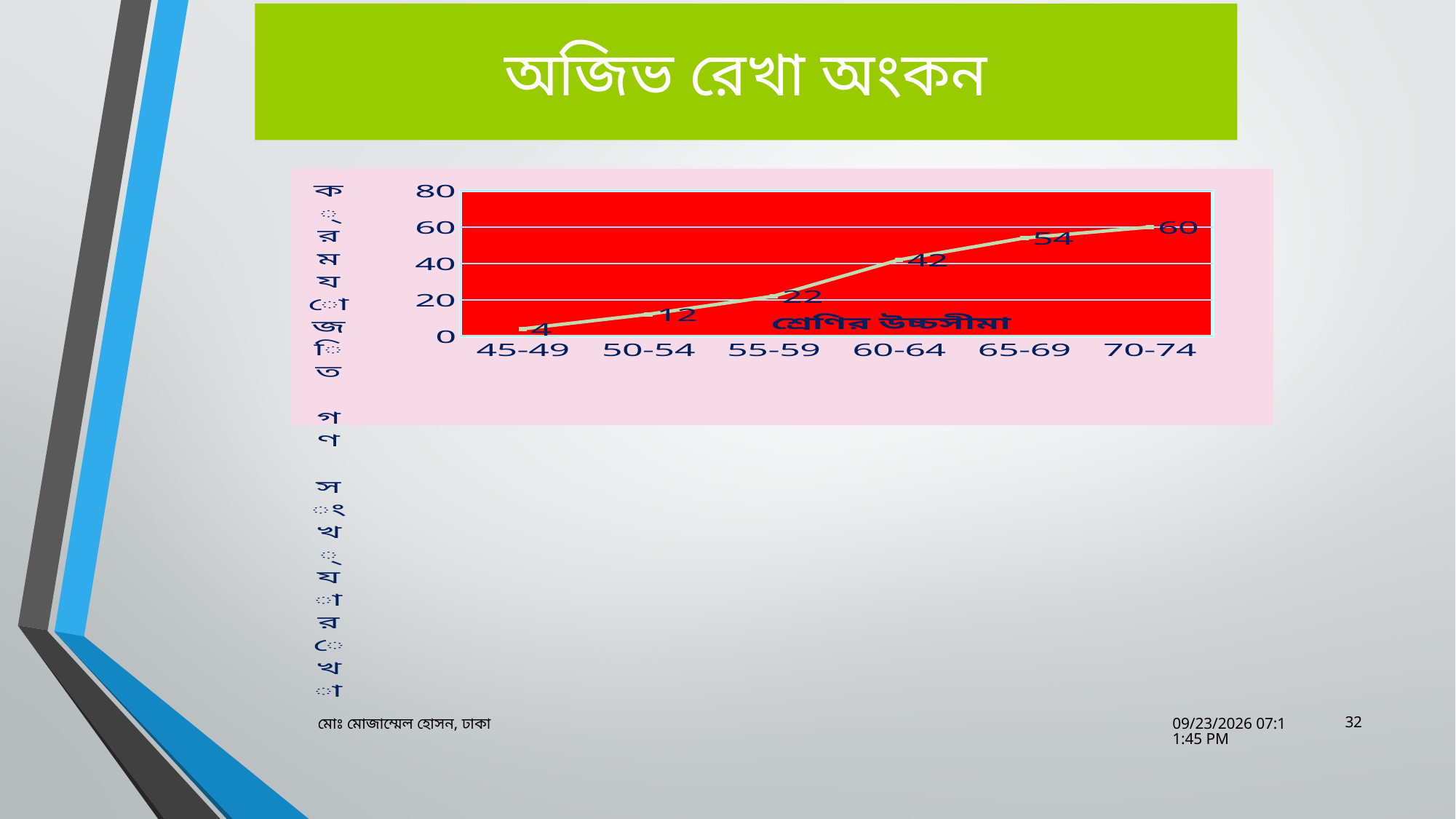
What is the label shown along the x axis of the chart? শ্রেণির উচ্চসীমা Which class has the lowest plotted value? 45-49 How many classes are plotted along the x axis? 6 Is the value for 65-69 greater or less than 40? greater Do the plotted values rise or fall from 45-49 to 70-74? rise What type of chart is shown on the slide? line chart What is the value plotted for the class 55-59? 22 What is the difference between the values for 60-64 and 50-54? 30 Which is larger, the value for 60-64 or the value for 55-59? 60-64 What is the value plotted for the class 45-49? 4 What is the value plotted for the class 65-69? 54 Which class has the highest plotted value? 70-74